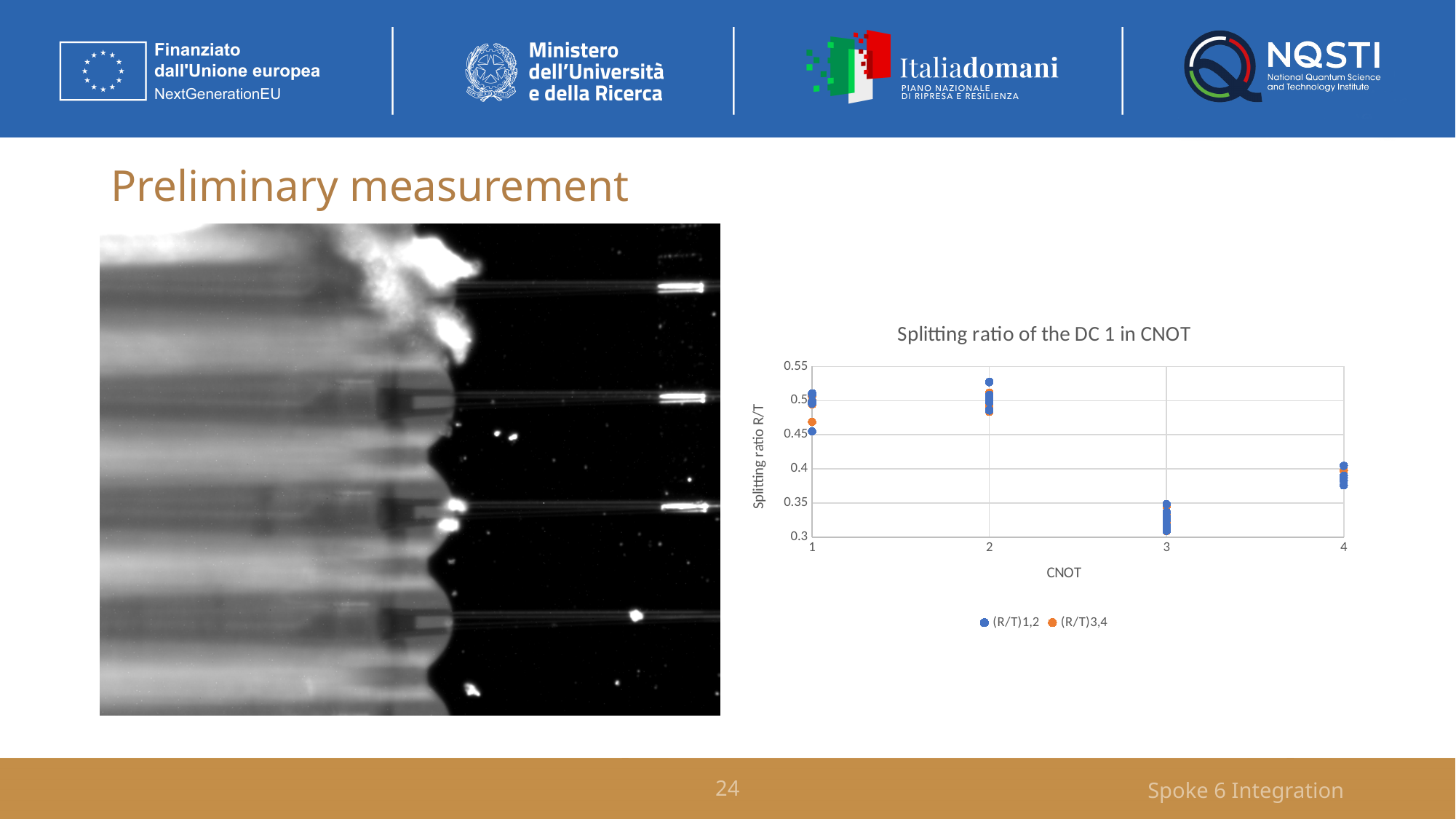
What is the title of the chart? Splitting ratio of the DC 1 in CNOT Are the splitting ratio values for CNOT 1 greater or less than 0.4? greater Are the splitting ratio values for CNOT 3 greater or less than 0.4? less Which CNOT has the lowest splitting ratio values? 3 Do the splitting ratio values rise or fall from CNOT 2 to CNOT 3? fall Are the splitting ratio values for CNOT 4 greater or less than 0.45? less What kind of chart is shown on the slide? scatter chart What are the two series names shown in the chart legend? (R/T)1,2 and (R/T)3,4 How many series does the legend of the chart list? 2 Which has larger splitting ratio values, CNOT 3 or CNOT 4? CNOT 4 How many CNOT values are plotted along the x axis of the chart? 4